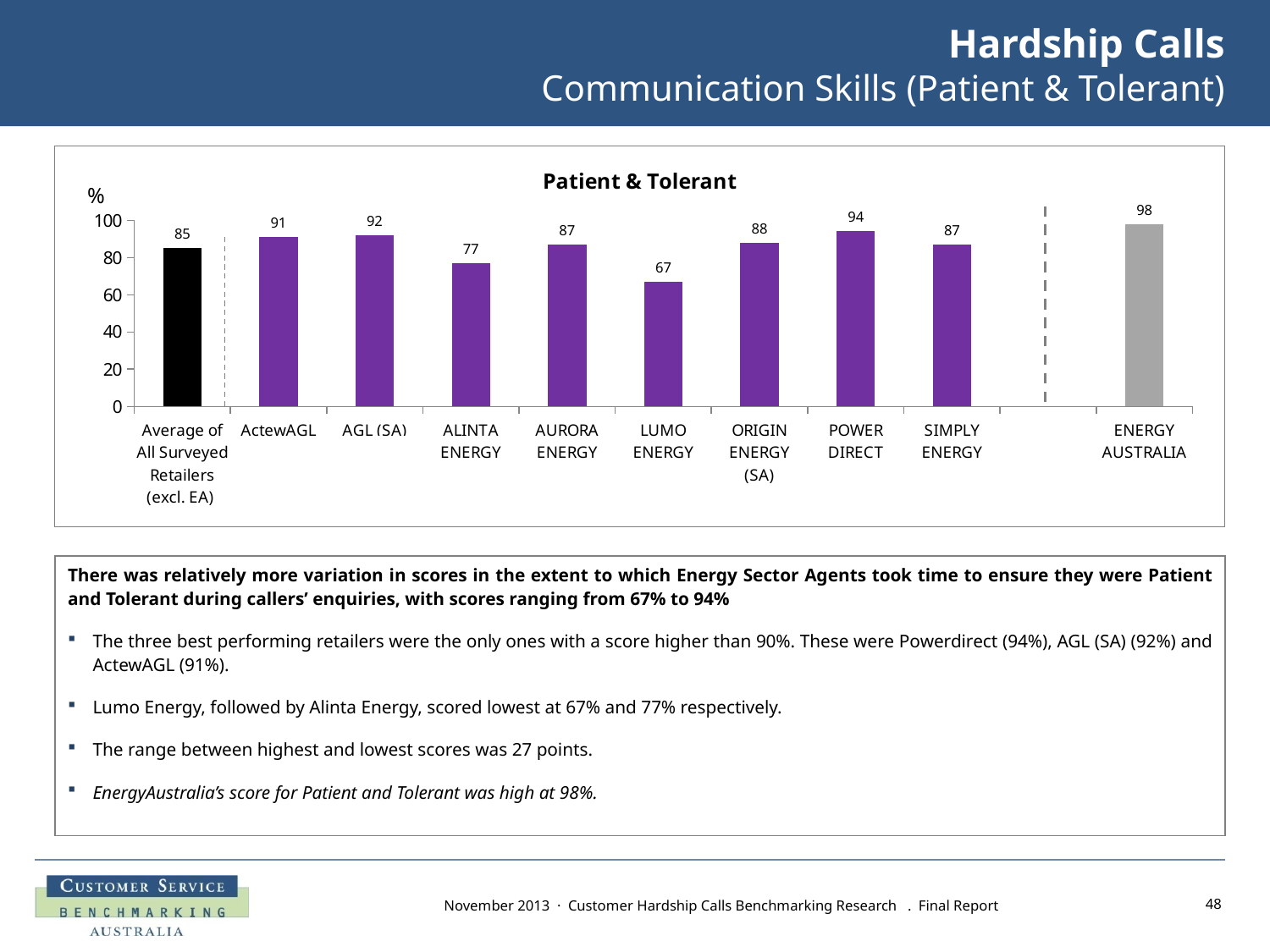
What is the value for Average of All Surveyed Retailers (excl. EA)? 85 What is the difference between the values for POWER DIRECT and LUMO ENERGY? 27 Is the value for ALINTA ENERGY greater or less than 80? less What is the value for LUMO ENERGY? 67 Which category has the highest value? ENERGY AUSTRALIA What is the value for ENERGY AUSTRALIA? 98 How many categories are shown on the x axis? 10 Which is larger, the value for AGL (SA) or the value for ActewAGL? AGL (SA) What is the value for POWER DIRECT? 94 Which category has the lowest value? LUMO ENERGY What kind of chart is this? bar chart What is the title of the chart? Patient & Tolerant